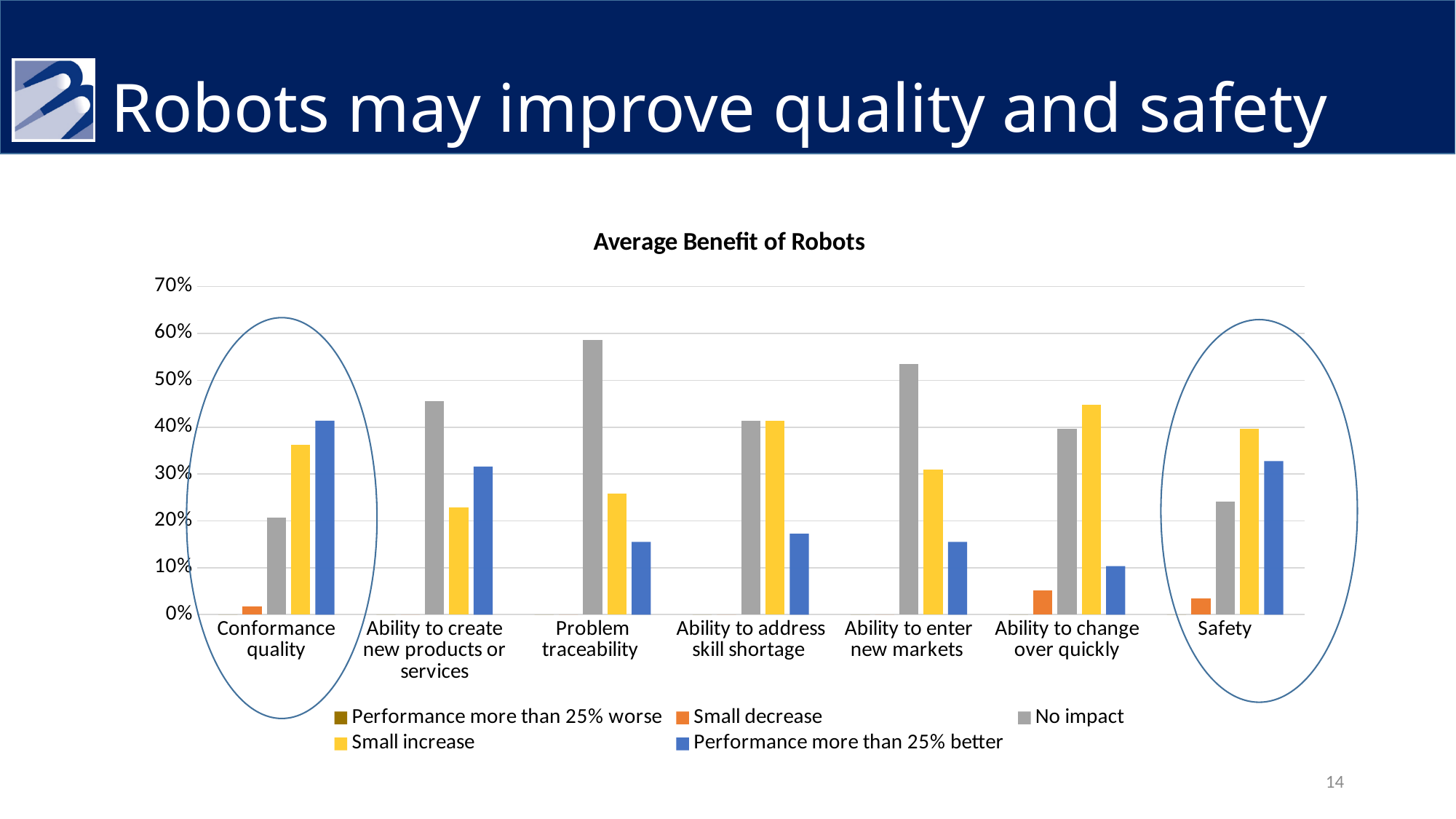
Which category has the highest 'No impact' bar? Problem traceability Which category has the lowest 'Performance more than 25% better' bar? Ability to change over quickly What is the title of the chart? Average Benefit of Robots How many categories are shown along the x axis of the chart? 7 Is the 'No impact' value for Problem traceability greater or less than 50%? greater Is the 'Performance more than 25% better' value for Ability to change over quickly greater or less than 20%? less Is the 'Small increase' value for Ability to change over quickly greater or less than 40%? greater For Ability to enter new markets, which is larger: the 'No impact' bar or the 'Small increase' bar? No impact What kind of chart is shown on the slide? Bar chart How many series does the legend of the chart list? 5 For Safety, which is larger: the 'Small increase' bar or the 'No impact' bar? Small increase Which category has the highest 'Performance more than 25% better' bar? Conformance quality